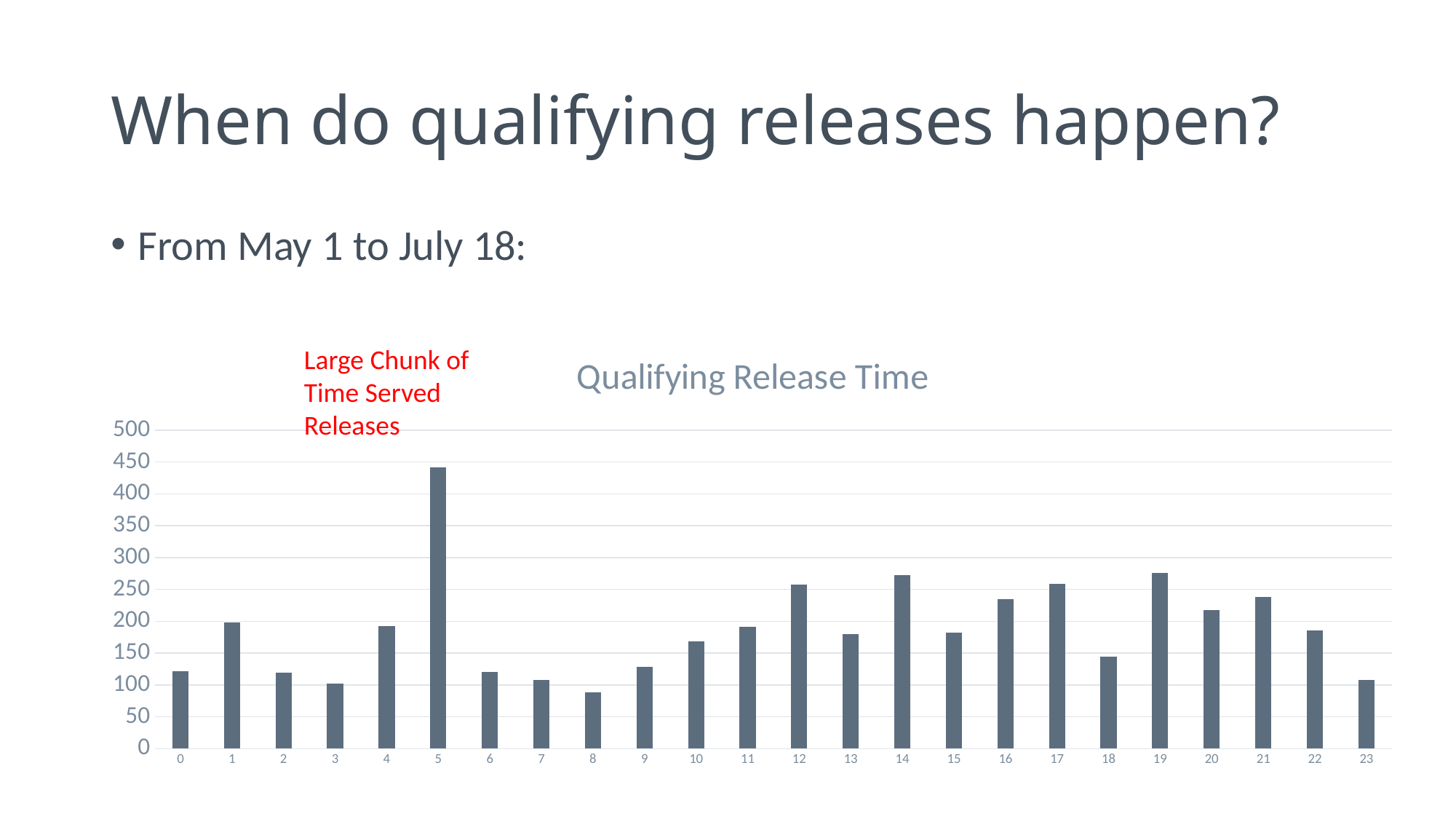
Which hour has the highest number of qualifying releases? 5 Is the value for hour 16 greater or less than 200? greater Which hour has the lowest number of qualifying releases? 8 What kind of chart is shown on the slide? bar chart How many categories (hours) are plotted along the x axis? 24 What is the title of the chart? Qualifying Release Time Is the value for hour 5 greater or less than 400? greater Is the value for hour 22 greater or less than 200? less Which is larger, the value for hour 19 or the value for hour 23? hour 19 What does the red annotation above hour 5 say? Large Chunk of Time Served Releases